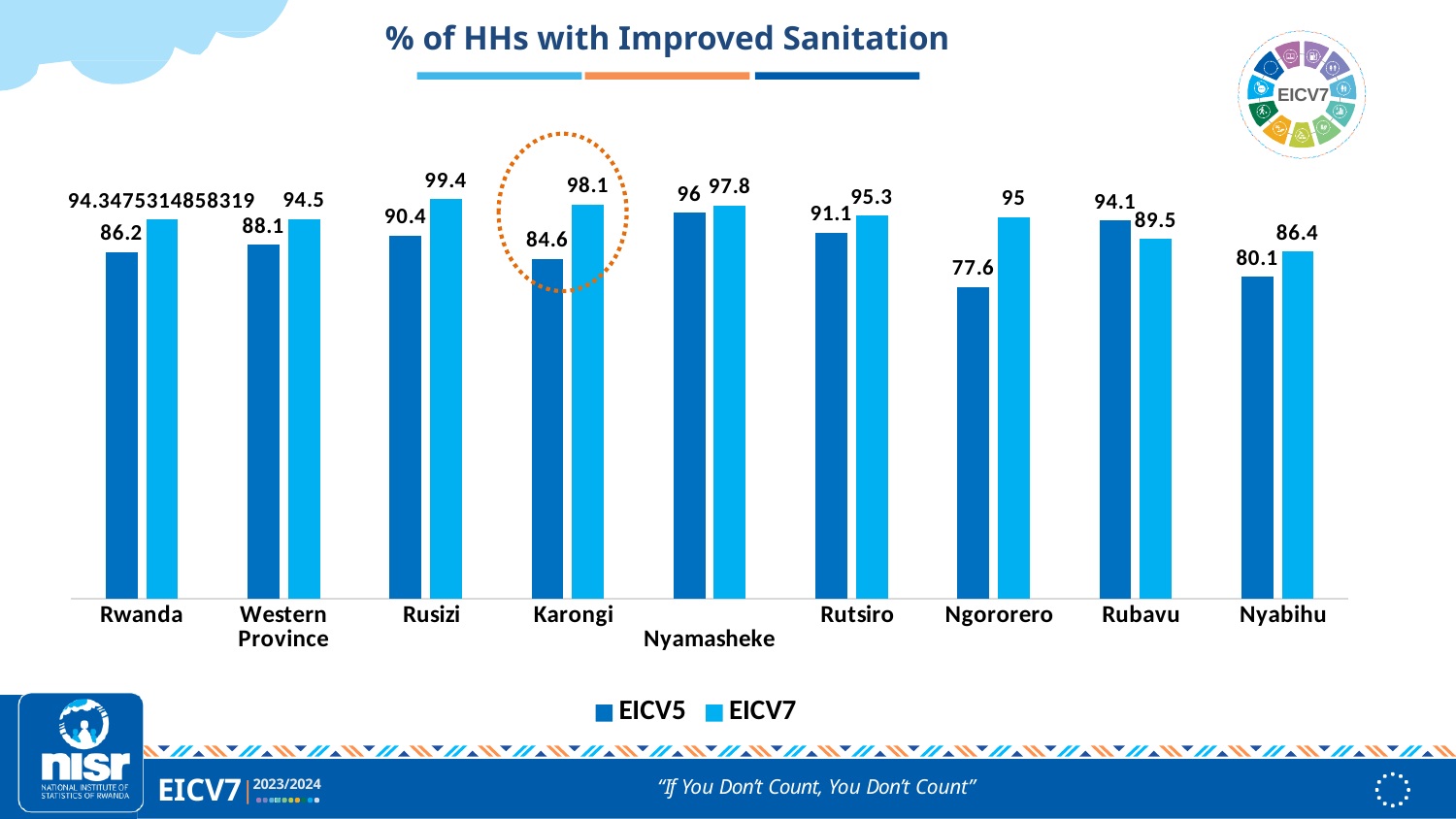
How many series does the legend list? 2 How many categories are shown on the x axis? 9 What is the EICV5 value for Nyamasheke? 96 Which is larger for Rubavu, the EICV5 value or the EICV7 value? EICV5 What kind of chart is shown on the slide? Bar chart What is the EICV5 value for Ngororero? 77.6 What is the difference between the EICV7 and EICV5 values for Karongi? 13.5 What is the EICV7 value for Rusizi? 99.4 Which category has the highest EICV7 value? Rusizi What is the title of the chart? % of HHs with Improved Sanitation What is the EICV7 value for Karongi? 98.1 Which district has the lowest EICV5 value? Ngororero